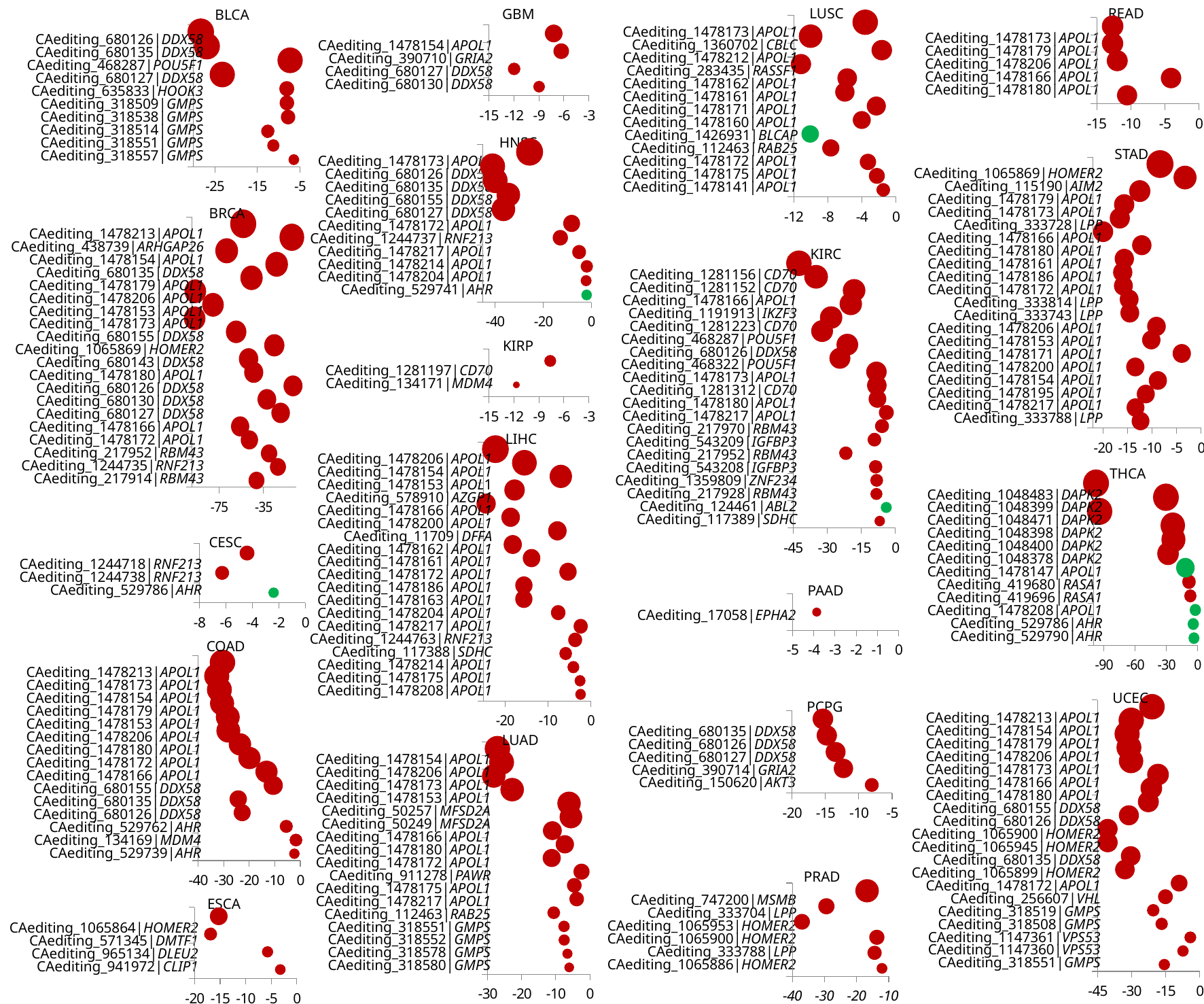
In the ESCA chart, how many categories are plotted? 4 In the PCPG chart, which has the larger (less negative) value: CAediting_150620|AKT3 or CAediting_680135|DDX58? CAediting_150620|AKT3 In the KIRP chart, how many categories are plotted? 2 In the PAAD chart, how many categories are plotted? 1 In the GBM chart, is the value for CAediting_680127|DDX58 greater or less than -9? less In the CESC chart, which category is shown with a green marker? CAediting_529786|AHR In the PAAD chart, is the value for CAediting_17058|EPHA2 greater or less than -3? less In the KIRP chart, is the value for CAediting_1281197|CD70 greater or less than -12? greater What kind of chart is used for each cancer type on this slide? bubble chart In the ESCA chart, which category has the lowest (most negative) value? CAediting_571345|DMTF1